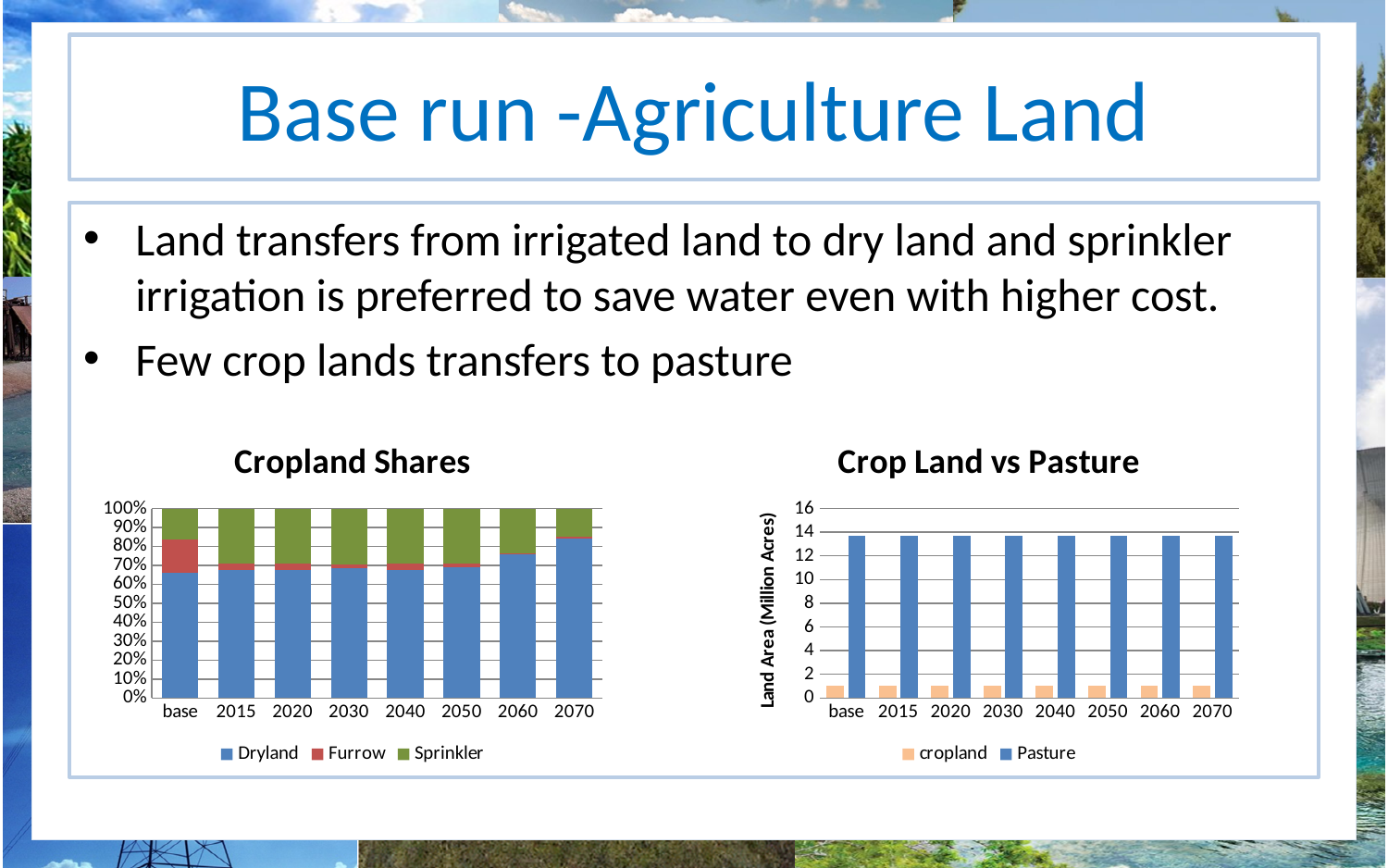
In the Cropland Shares chart, how many series does the legend list? 3 In the Cropland Shares chart, which is larger, the Furrow share for base or the Furrow share for 2070? base In the Crop Land vs Pasture chart, is the cropland value for base greater or less than 2? less What kind of chart is the Crop Land vs Pasture chart? bar chart In the Cropland Shares chart, what is the total height of each stacked bar? 100% In the Cropland Shares chart, how many categories are shown on the x axis? 8 In the Cropland Shares chart, does the Dryland share rise or fall from base to 2070? rise In the Cropland Shares chart, is the Dryland share for 2070 greater or less than 70%? greater In the Crop Land vs Pasture chart, what is the y-axis title? Land Area (Million Acres) In the Crop Land vs Pasture chart, how many series does the legend list? 2 In the Crop Land vs Pasture chart, is the Pasture value for 2050 greater or less than 12? greater